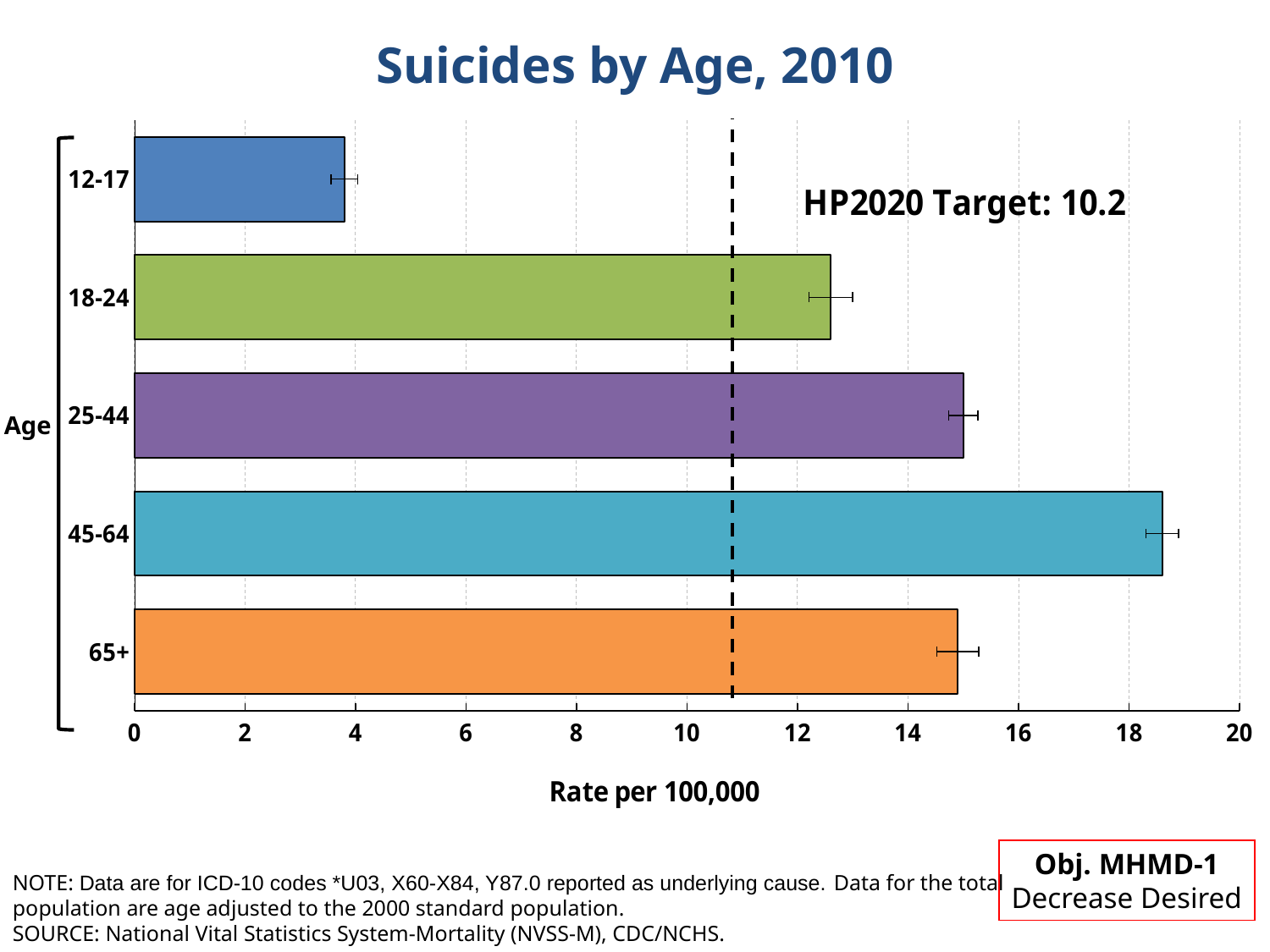
Which age group has the lowest suicide rate? 12-17 Which age group has the highest suicide rate? 45-64 Is the value for the 18-24 age group greater or less than 12? greater What kind of chart is shown on the slide? bar chart How many age groups are plotted in the chart? 5 Is the value for the 45-64 age group greater or less than 18? greater Which has a higher suicide rate, the 25-44 age group or the 12-17 age group? 25-44 Which has a higher suicide rate, the 45-64 age group or the 18-24 age group? 45-64 What is the HP2020 Target value shown on the chart? 10.2 What is the label of the x axis? Rate per 100,000 Is the value for the 65+ age group greater or less than 16? less